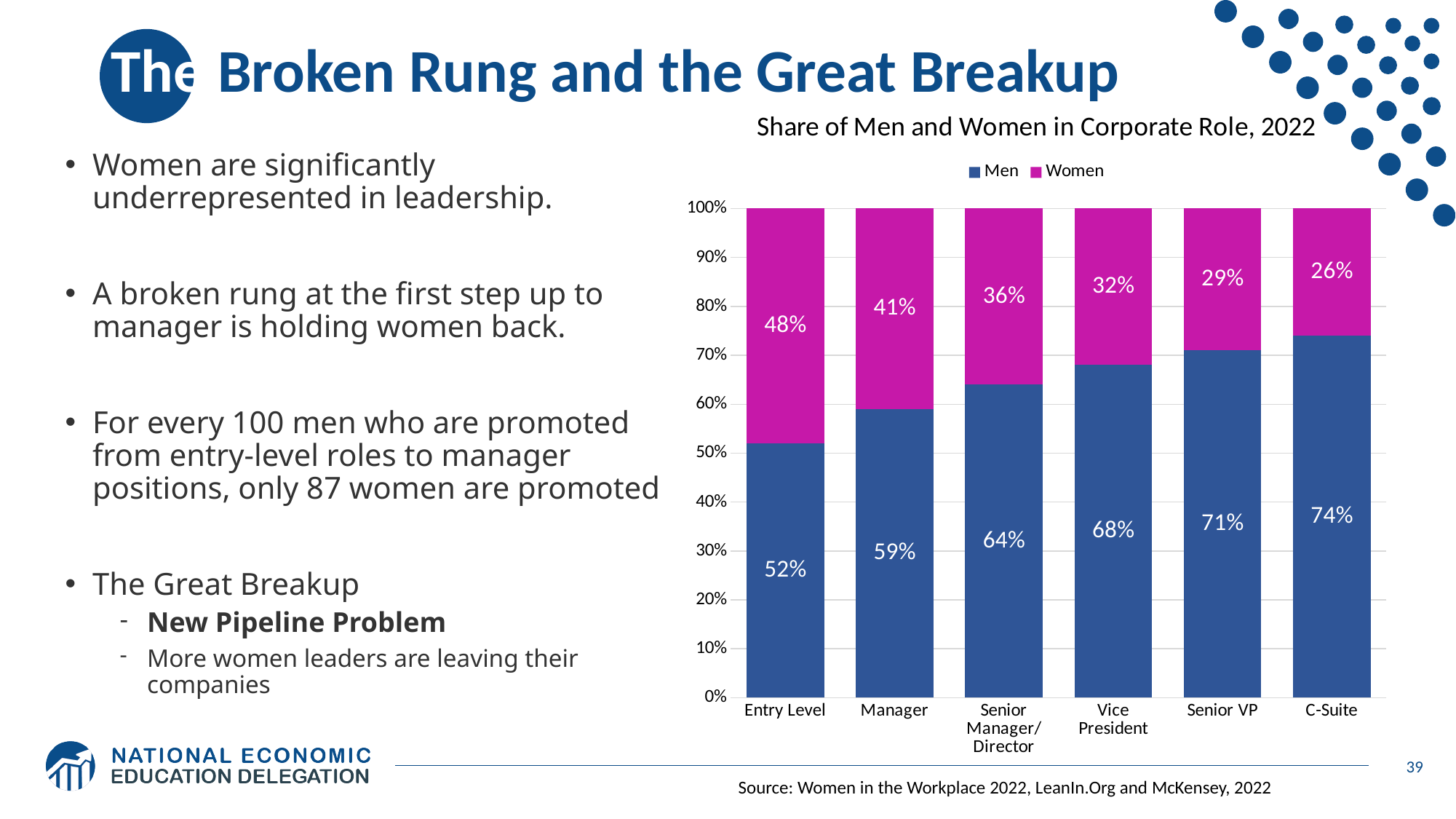
Which corporate role has the lowest share of men? Entry Level What is the title of the chart? Share of Men and Women in Corporate Role, 2022 What is the difference between the share of men and the share of women at the Manager level? 18% What is the share of men in the C-Suite? 74% Does the share of women rise or fall moving from Entry Level to C-Suite? Fall What kind of chart is shown on the slide? Stacked bar chart What is the share of women at the Vice President level? 32% How many corporate roles are shown on the x axis? 6 How many series does the legend list? 2 Is the share of men larger at Senior VP or at Senior Manager/Director? Senior VP What is the share of women at the Entry Level? 48% Which corporate role has the highest share of women? Entry Level